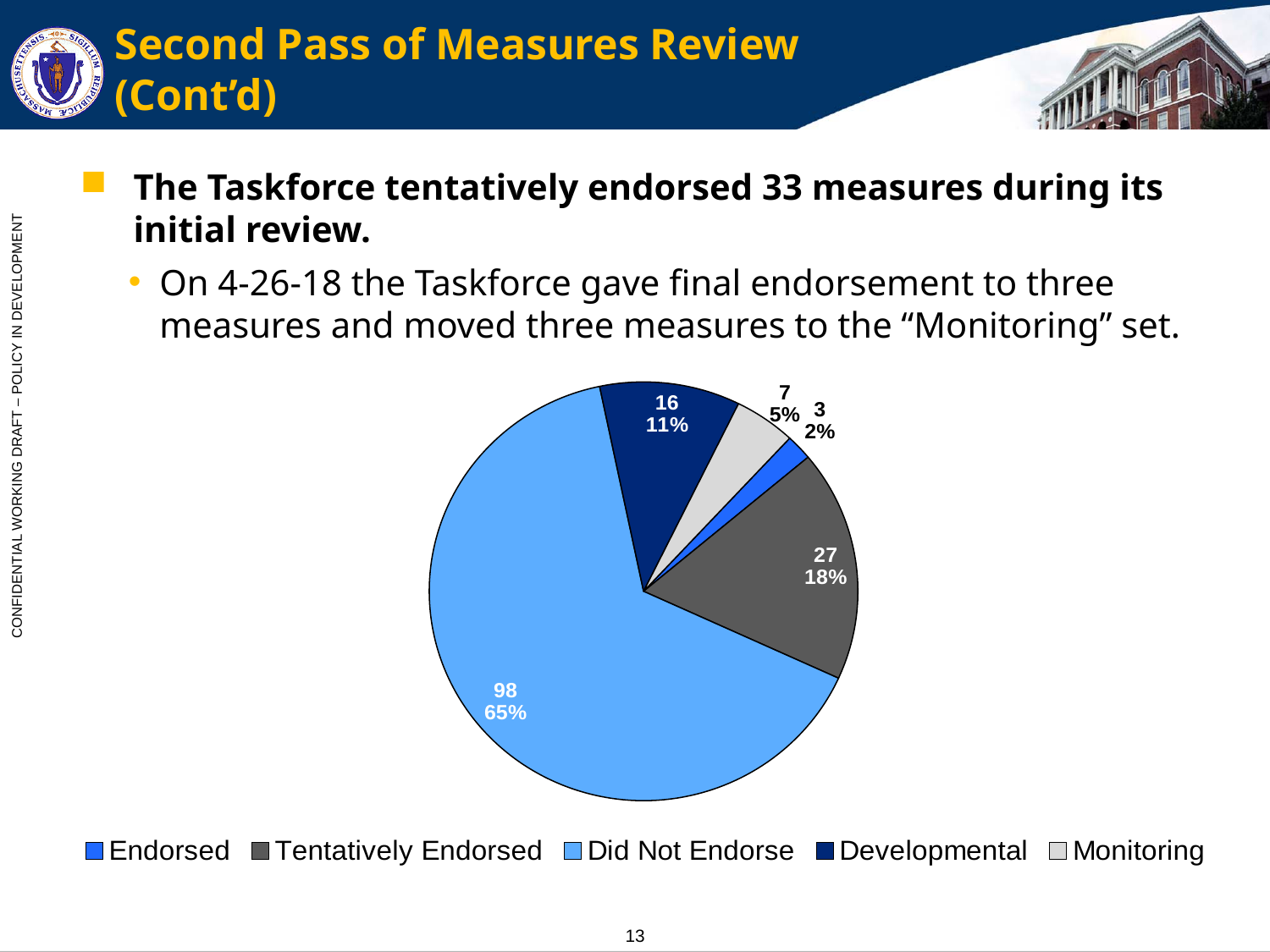
What is the value for Monitoring in the pie chart? 7 What kind of chart is shown on the slide? pie chart What is the value for Developmental in the pie chart? 16 What is the value for Did Not Endorse in the pie chart? 98 Which category has the largest slice in the pie chart? Did Not Endorse How many entries does the legend of the pie chart list? 5 What is the value for Tentatively Endorsed in the pie chart? 27 What share of the pie does Endorsed represent? 2% What is the difference between the values for Tentatively Endorsed and Developmental? 11 What share of the pie does Did Not Endorse represent? 65% Which category has the smallest slice in the pie chart? Endorsed How many slices does the pie chart have? 5